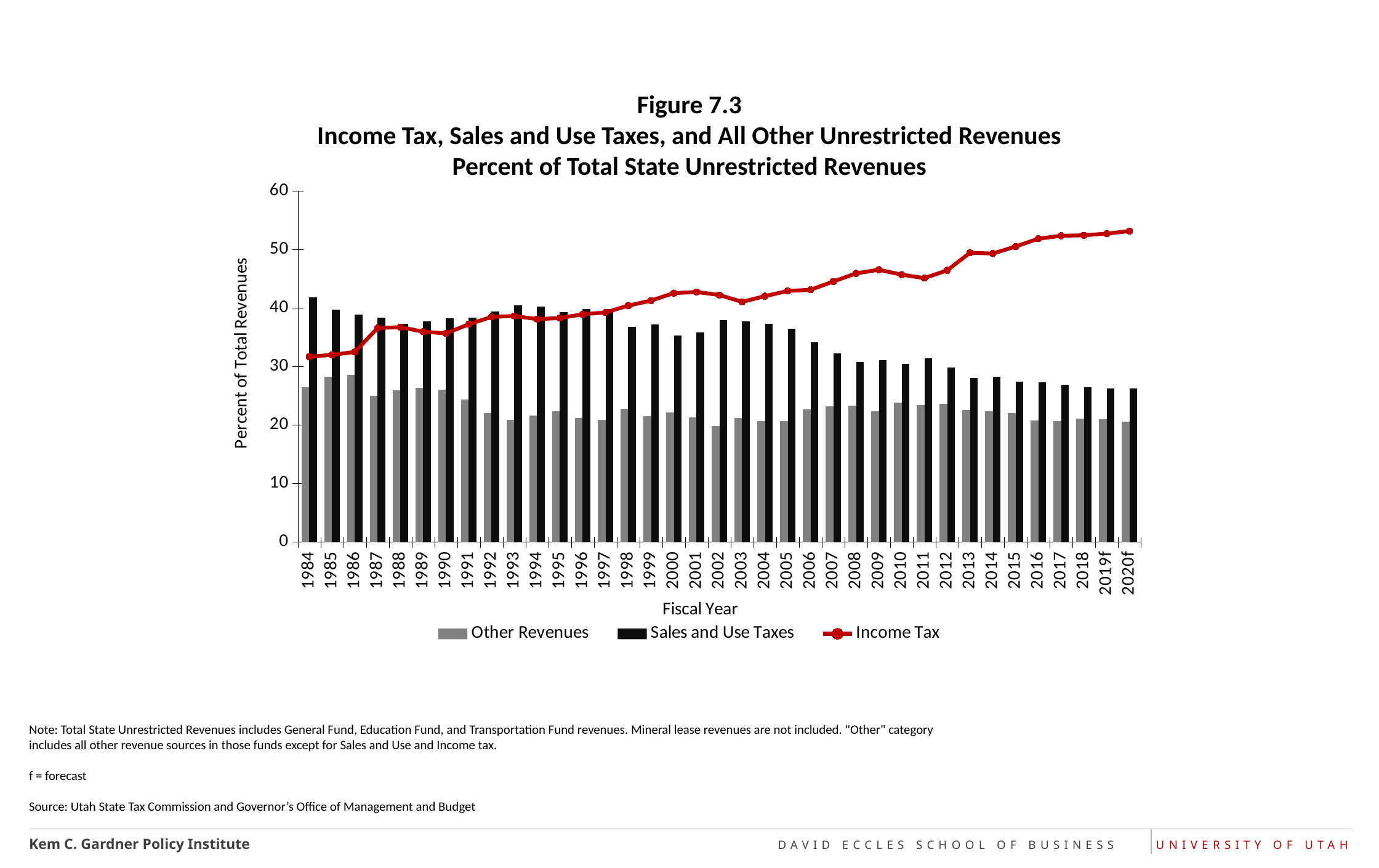
Is the Sales and Use Taxes value for 2020f greater or less than 30? less Which series is plotted as a red line? Income Tax In which fiscal year is the Income Tax share lowest? 1984 In which fiscal year is the Sales and Use Taxes share highest? 1984 Do the Sales and Use Taxes bars rise or fall overall from 1984 to 2020f? Fall Does the Income Tax line rise or fall overall from 1984 to 2020f? Rises How many fiscal years are shown on the x axis? 37 In 1984, which is larger: Sales and Use Taxes or Income Tax? Sales and Use Taxes Is the Income Tax value for 2020f greater or less than 50? greater In which fiscal year is the Income Tax share highest? 2020f What kind of chart is shown in Figure 7.3? A combined bar and line chart How many series does the legend list? 3